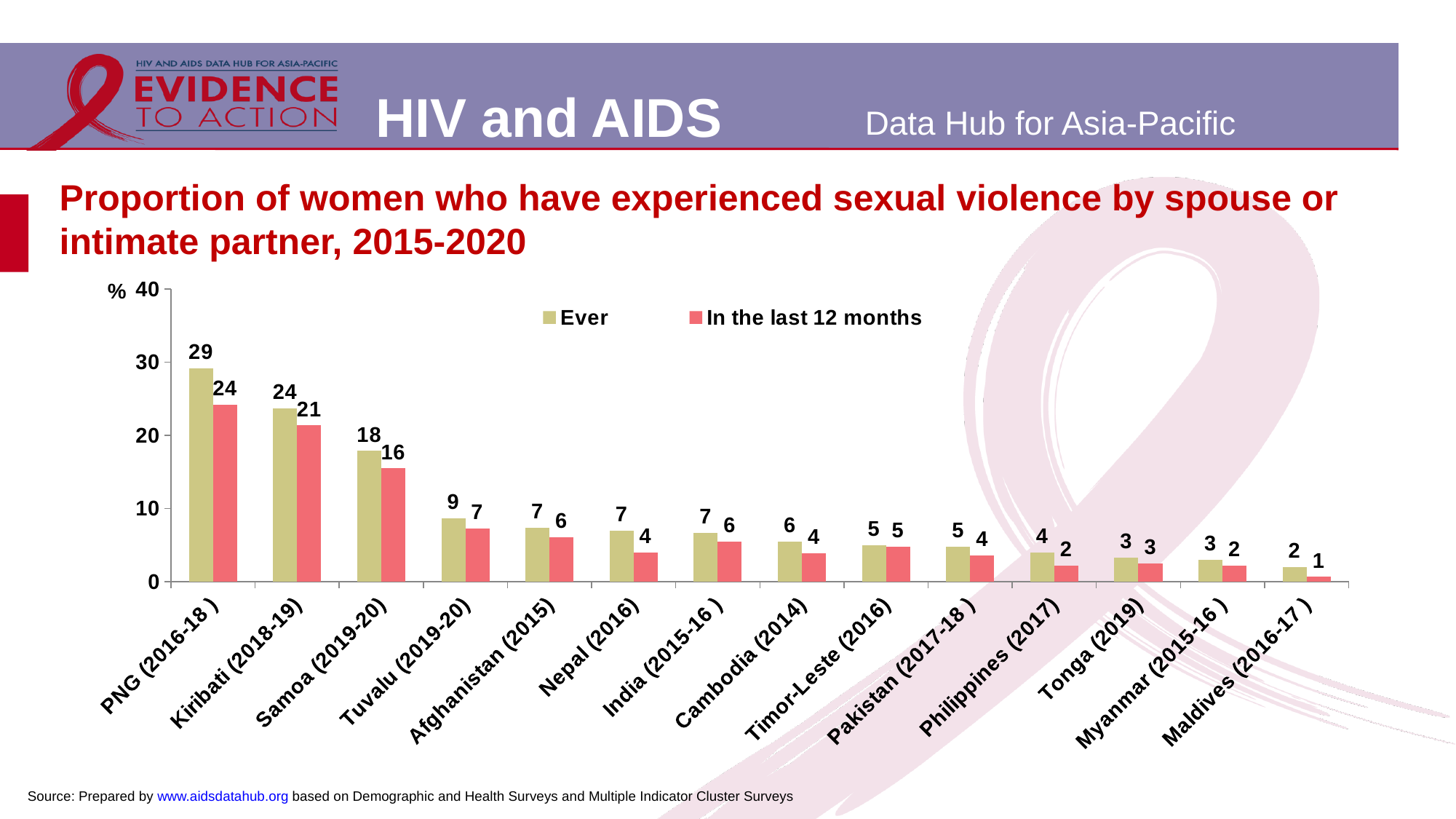
How many series does the legend list? 2 Which is larger for Nepal (2016): the 'Ever' value or the 'In the last 12 months' value? Ever What is the difference between the 'Ever' and 'In the last 12 months' values for Kiribati (2018-19)? 3 What kind of chart is shown on the slide? bar chart What is the 'In the last 12 months' value for Samoa (2019-20)? 16 Do the 'Ever' values rise or fall from left to right along the x axis? fall Is the 'Ever' value for Samoa (2019-20) greater or less than 20? less Which country has the lowest 'In the last 12 months' value? Maldives (2016-17) Which country has the highest 'Ever' value? PNG (2016-18) What are the two series named in the legend? Ever; In the last 12 months What is the 'Ever' value for PNG (2016-18)? 29 How many countries are shown on the x axis? 14